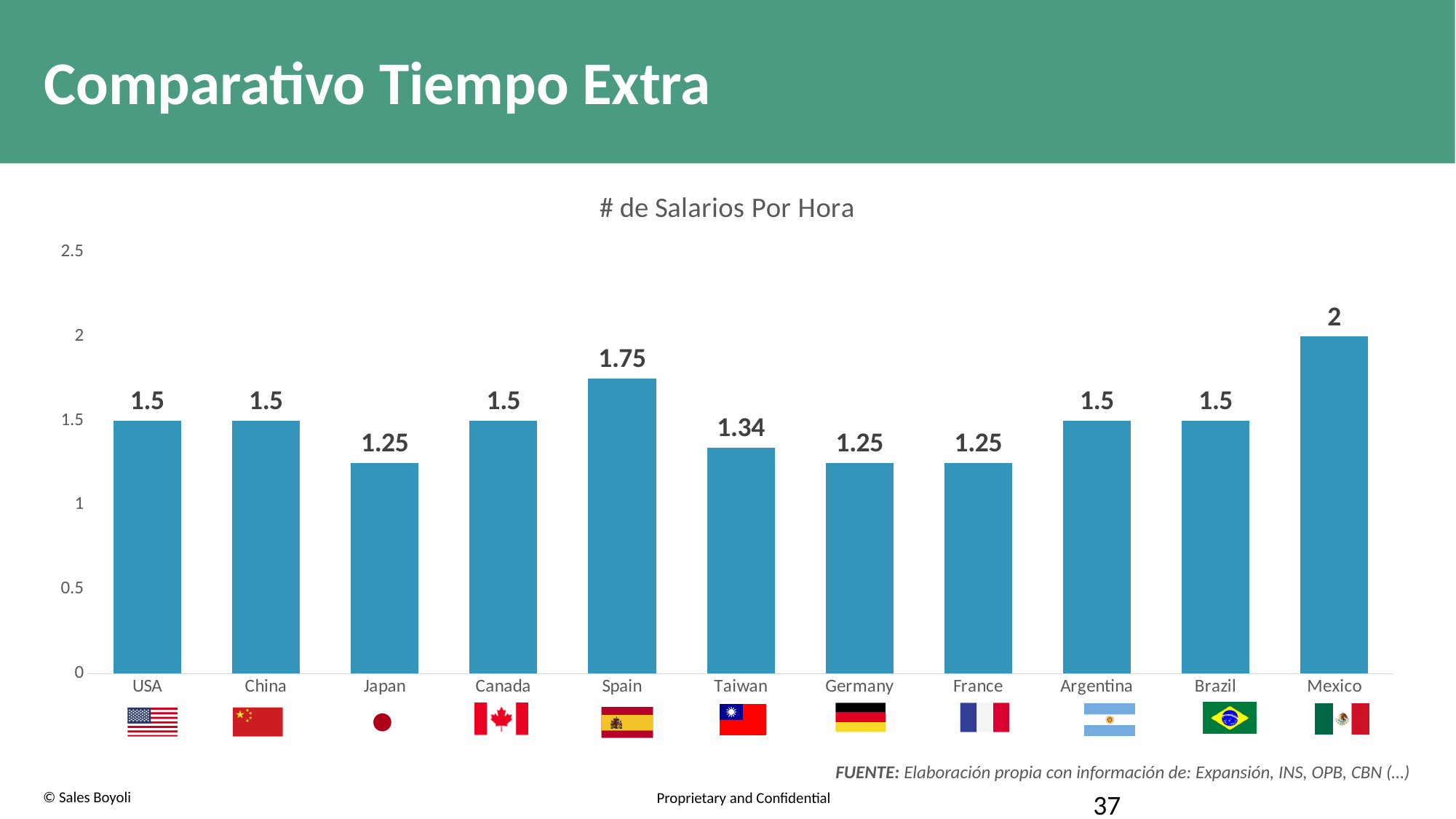
What is the difference between the values for Taiwan and Japan? 0.09 Which is larger, the value for Taiwan or the value for France? Taiwan What is the value for Spain? 1.75 What kind of chart is shown on the slide? Bar chart What is the value for Germany? 1.25 What is the title of the chart? # de Salarios Por Hora Which is larger, the value for Spain or the value for Canada? Spain Which country has the highest value? Mexico How many countries are shown on the chart? 11 What is the difference between the values for Mexico and Spain? 0.25 Is the value for Mexico greater or less than 1.5? greater What is the value for Taiwan? 1.34